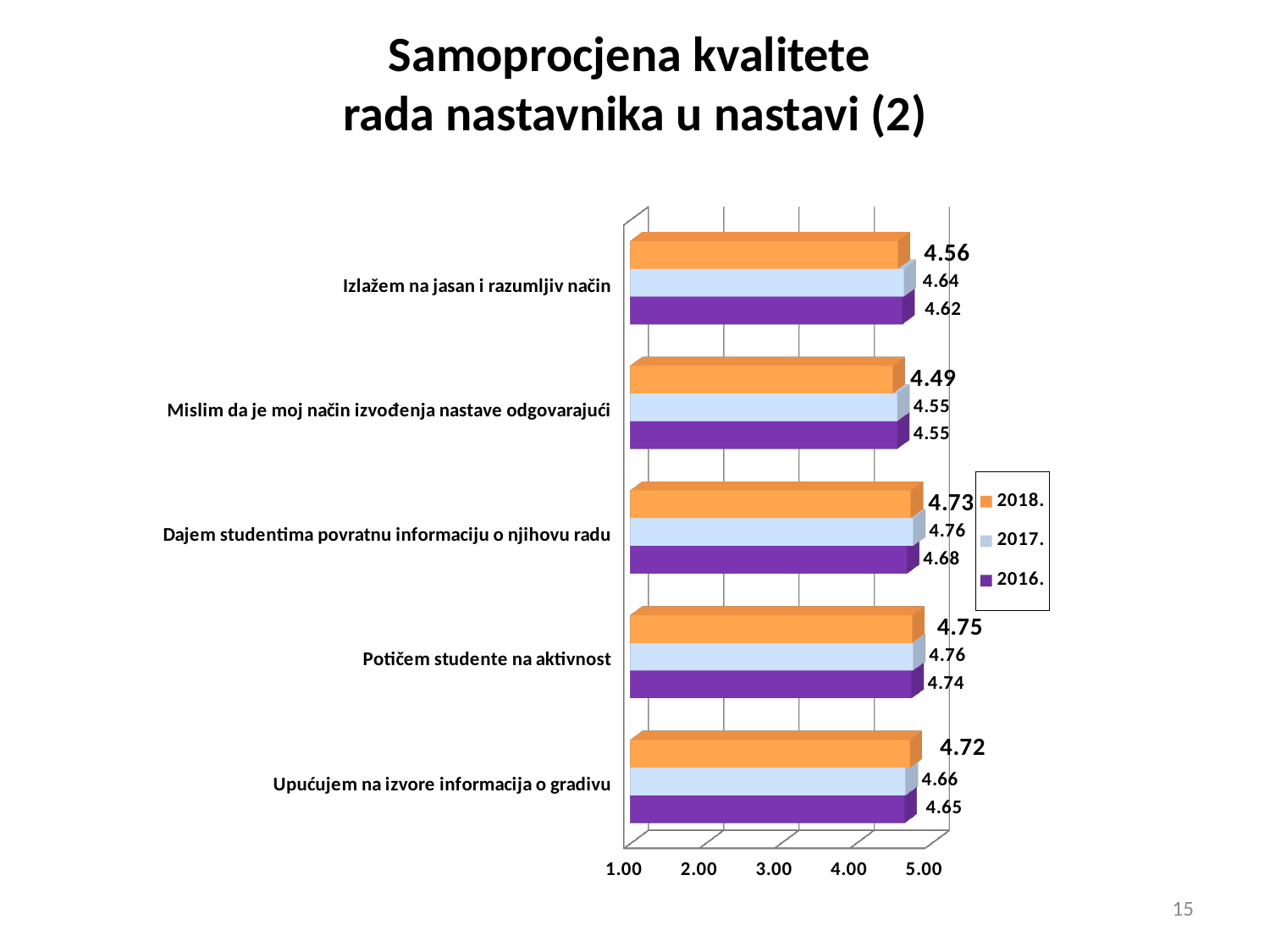
Is the 2018. value for "Mislim da je moj način izvođenja nastave odgovarajući" greater or less than 4.00? greater For "Upućujem na izvore informacija o gradivu", which year has the larger value, 2018. or 2016.? 2018. How many categories are shown on the chart? 5 What is the 2018. value for "Izlažem na jasan i razumljiv način"? 4.56 How many series does the legend list? 3 Which colour represents the 2016. series in the legend? Purple What kind of chart is shown on the slide? Bar chart Which category has the lowest 2018. value? Mislim da je moj način izvođenja nastave odgovarajući What is the 2016. value for "Upućujem na izvore informacija o gradivu"? 4.65 What is the 2017. value for "Dajem studentima povratnu informaciju o njihovu radu"? 4.76 Which category has the highest 2018. value? Potičem studente na aktivnost What is the difference between the 2017. and 2018. values for "Izlažem na jasan i razumljiv način"? 0.08